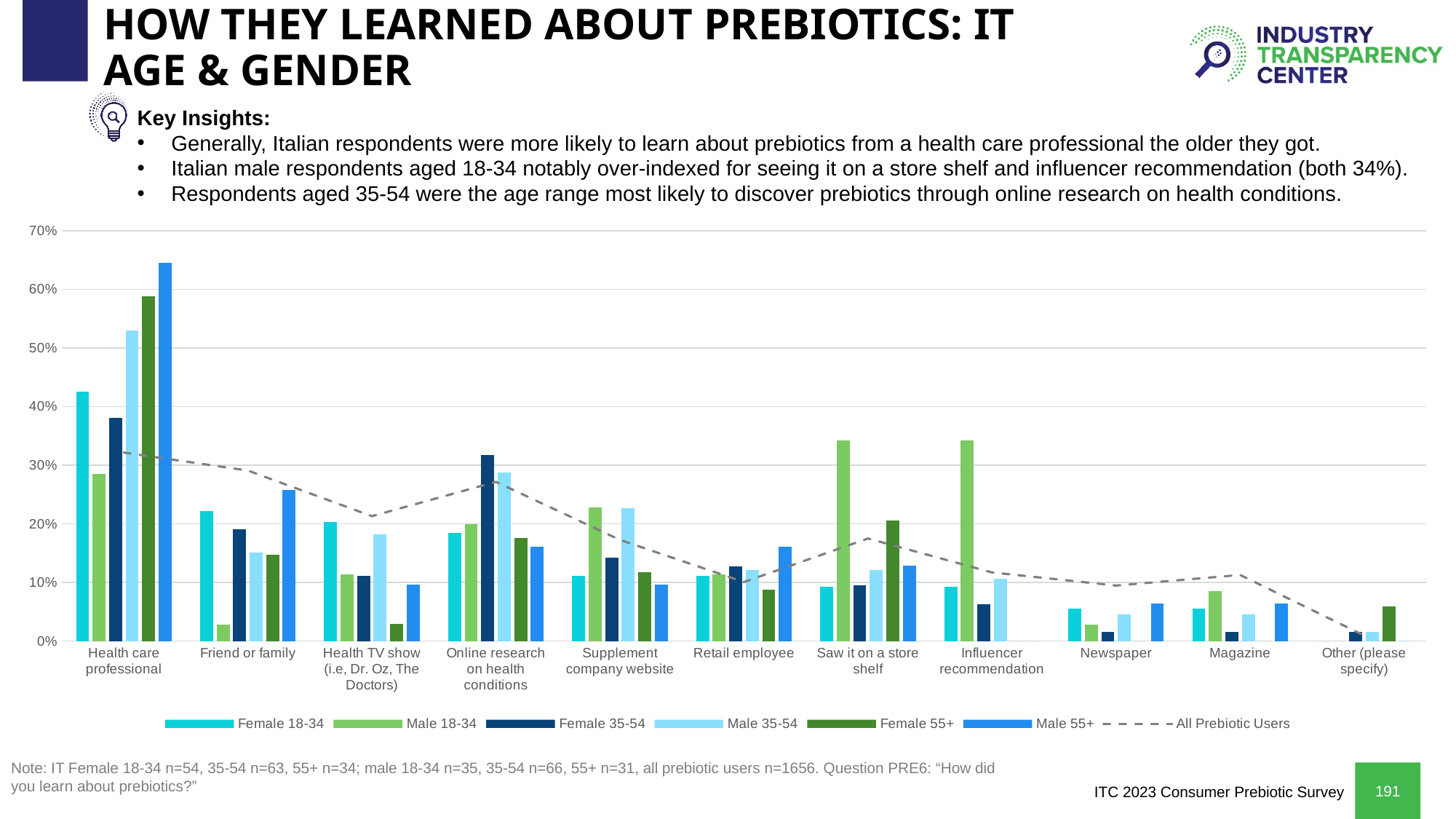
Which category has the highest value for Male 55+? Health care professional What kind of chart is shown on the slide? Combination bar and line chart Is the value for Male 18-34 in Saw it on a store shelf greater or less than 30%? greater Is the value for Male 55+ in Health care professional greater or less than 60%? greater Is the value for Female 55+ in Health TV show (i.e, Dr. Oz, The Doctors) greater or less than 10%? less Which series is shown as a dashed line rather than bars? All Prebiotic Users For Health care professional, which is larger: Male 55+ or Female 55+? Male 55+ How many series does the legend list? 7 For Friend or family, which is larger: Female 18-34 or Male 18-34? Female 18-34 How many categories are shown along the x axis? 11 Does the All Prebiotic Users dashed line generally rise or fall from Health care professional to Other (please specify)? Fall Which series has the highest value for Influencer recommendation? Male 18-34